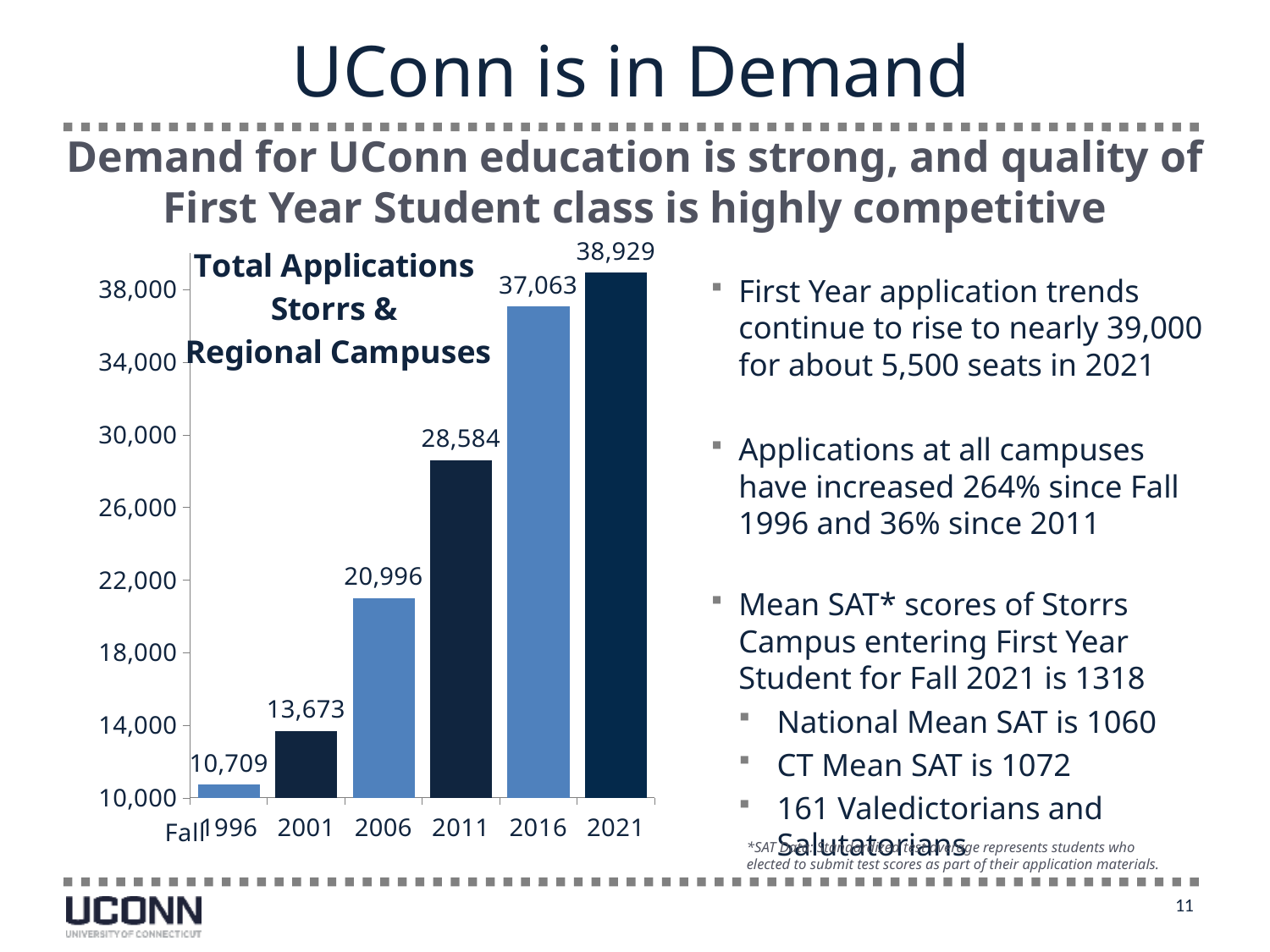
What is the value for 1996 in the Total Applications chart? 10,709 Which year has the lowest number of total applications? 1996 What is the difference between the 2011 and 2006 values in the Total Applications chart? 7,588 Do the values in the Total Applications chart rise or fall from 1996 to 2021? rise Is the value for 2016 greater or less than 34,000? greater What is the value for 2011 in the Total Applications chart? 28,584 What is the difference between the 2021 and 2016 values in the Total Applications chart? 1,866 What kind of chart is used to show Total Applications? bar chart How many years are shown on the x axis of the Total Applications chart? 6 Which is larger, the value for 2001 or the value for 2006? 2006 Which year has the highest number of total applications? 2021 What is the value for 2021 in the Total Applications chart? 38,929